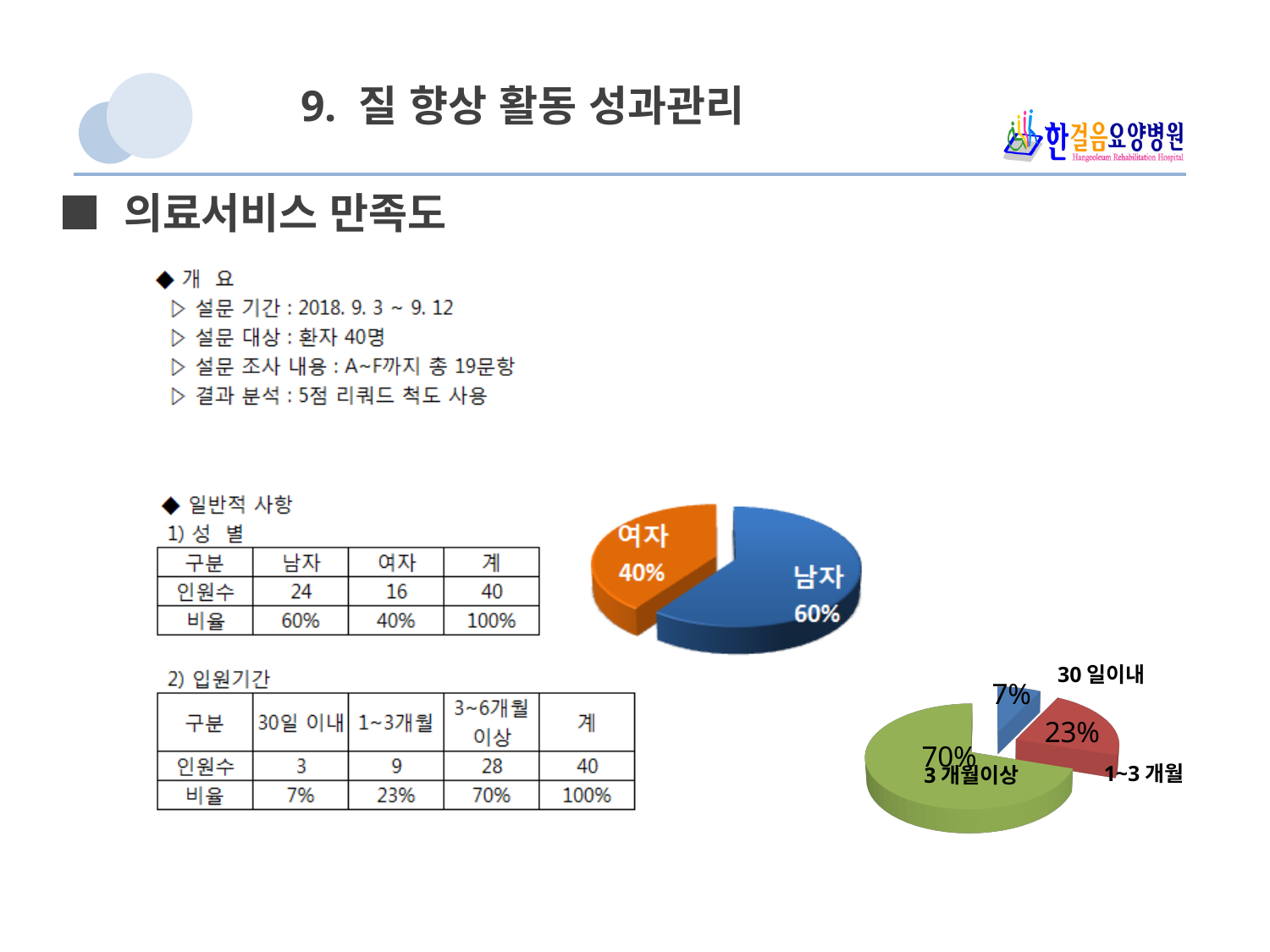
In the lower pie chart (hospitalization period), which category has the smallest slice? 30 일이내 In the upper pie chart (gender), what is the difference in percentage points between the 남자 and 여자 slices? 20% In the upper pie chart (gender), what share is labelled for 여자? 40% In the upper pie chart (gender), what share is labelled for 남자? 60% In the upper pie chart (gender), which slice is larger, 남자 or 여자? 남자 In the lower pie chart (hospitalization period), what share is labelled for 3 개월이상? 70% How many slices does the upper pie chart (gender) have? 2 What type of chart is the upper chart showing 남자 and 여자? Pie chart In the lower pie chart (hospitalization period), which category has the largest slice? 3 개월이상 In the lower pie chart (hospitalization period), what share is labelled for 30 일이내? 7% In the lower pie chart (hospitalization period), what colour is the 3 개월이상 slice? Green In the lower pie chart (hospitalization period), what share is labelled for 1~3 개월? 23%